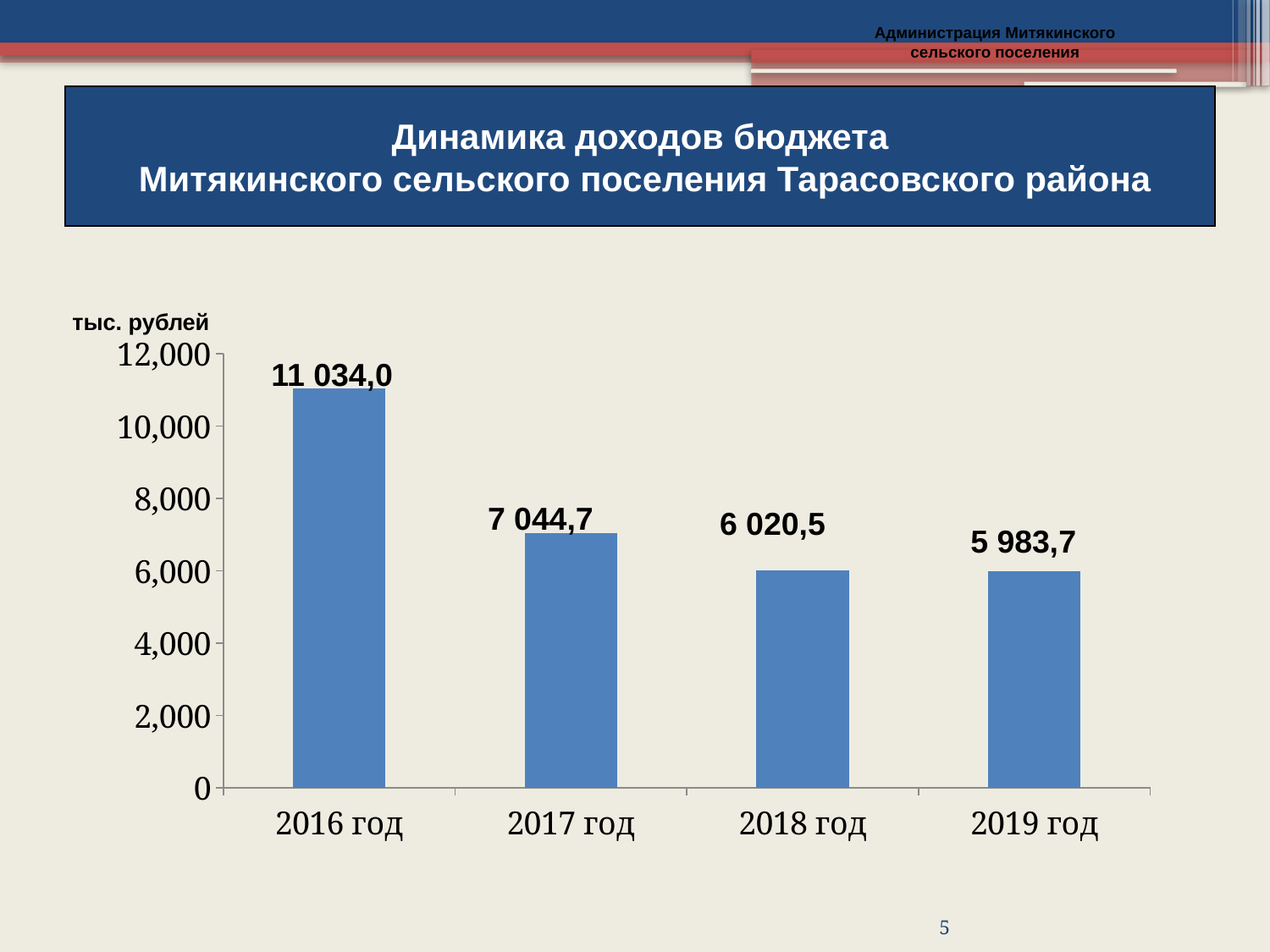
Is the value for 2017 год greater or less than 8,000? less Which is larger, the value for 2016 год or the value for 2017 год? 2016 год What is the difference between the values for 2017 год and 2018 год? 1 024,2 What is the budget revenue value shown for 2016 год? 11 034,0 What is the value shown for 2018 год? 6 020,5 Do the values rise or fall from 2016 год to 2019 год? fall Which year has the highest value on the chart? 2016 год How many years are shown on the chart? 4 Which year has the lowest value on the chart? 2019 год What is the value shown for 2019 год? 5 983,7 What is the difference between the values for 2016 год and 2017 год? 3 989,3 What is the value shown for 2017 год? 7 044,7